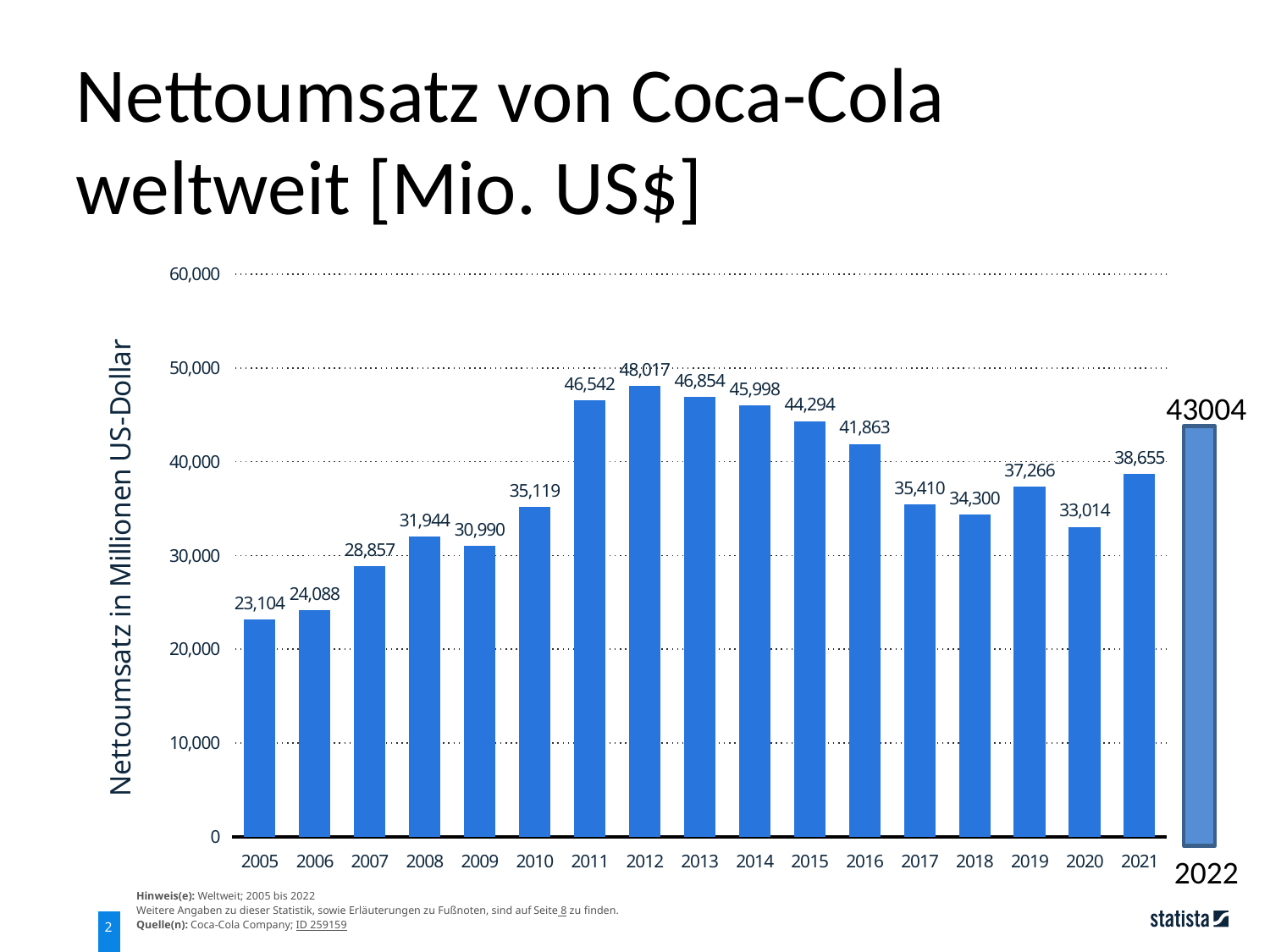
What is the title of the vertical axis? Nettoumsatz in Millionen US-Dollar What was Coca-Cola's net revenue in 2012 according to the chart? 48,017 Which year has the lowest net revenue in the chart? 2005 Do the values rise or fall from 2012 to 2018? fall What kind of chart is shown on the slide? bar chart Which year has the larger value, 2018 or 2019? 2019 By how much did the value increase from 2020 to 2021? 5,641 What is the difference between the values for 2012 and 2011? 1,475 Is the value for 2010 greater or less than 40,000? less What value is shown for 2005? 23,104 What value is shown for the 2022 bar on the right of the chart? 43004 Which year has the highest net revenue in the chart? 2012